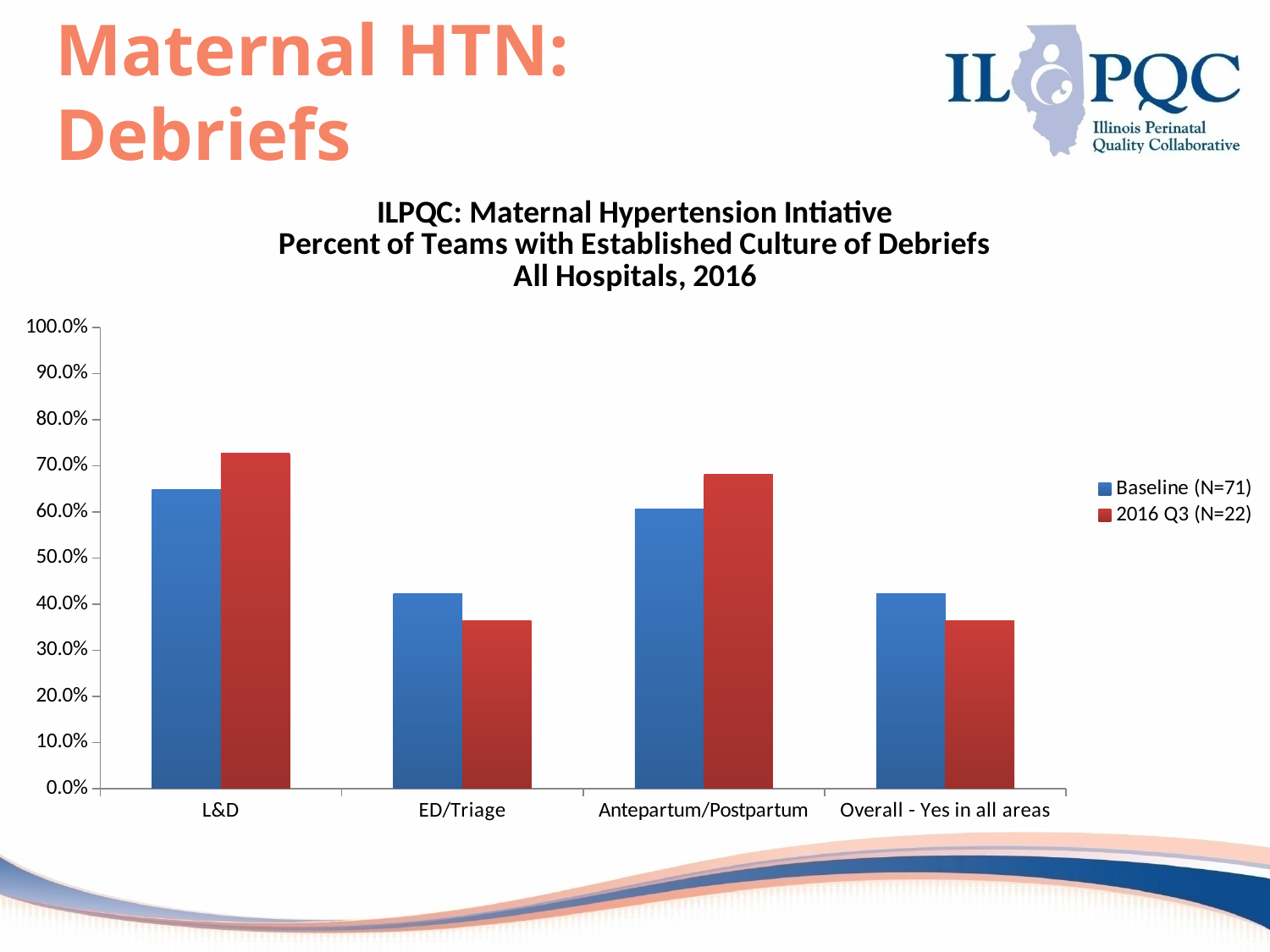
Is the 2016 Q3 (N=22) value for ED/Triage greater or less than 40.0%? less Which category has the highest 2016 Q3 (N=22) value? L&D What colour are the bars for the 2016 Q3 (N=22) series? red For Antepartum/Postpartum, which is larger: the Baseline (N=71) value or the 2016 Q3 (N=22) value? 2016 Q3 (N=22) Is the 2016 Q3 (N=22) value for L&D greater or less than 70.0%? greater For L&D, which is larger: the Baseline (N=71) value or the 2016 Q3 (N=22) value? 2016 Q3 (N=22) For ED/Triage, which is larger: the Baseline (N=71) value or the 2016 Q3 (N=22) value? Baseline (N=71) How many series does the chart's legend list? 2 Is the Baseline (N=71) value for Overall - Yes in all areas greater or less than 40.0%? greater Which category has the highest Baseline (N=71) value? L&D How many categories are shown on the x axis of the chart? 4 What kind of chart is shown on the slide? bar chart